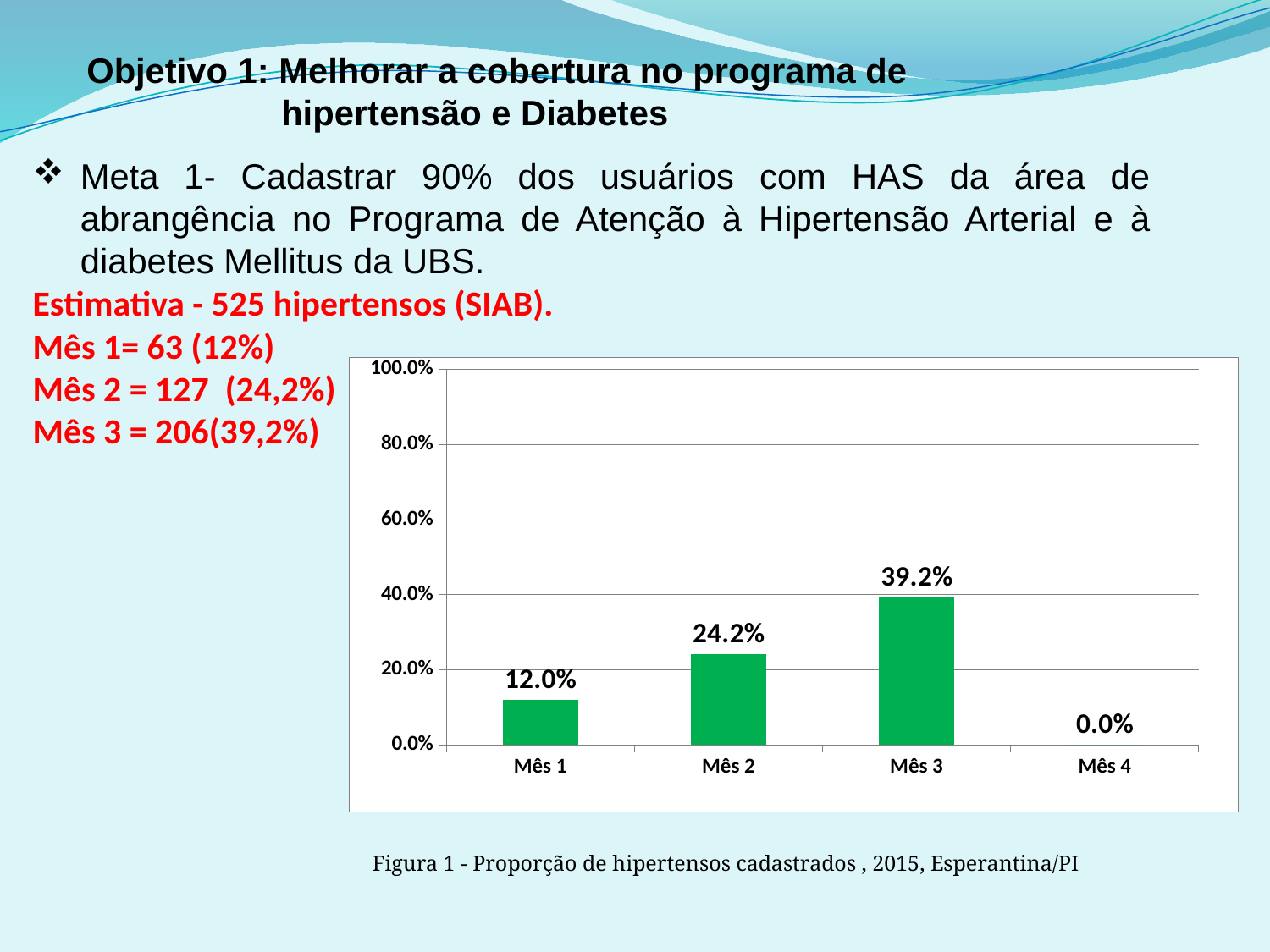
What is the value for Mês 1? 12.0% How many categories are shown on the x axis? 4 Which category has the lowest value? Mês 4 What is the difference between the values for Mês 3 and Mês 2? 15.0% What kind of chart is shown? bar chart What is the value for Mês 4? 0.0% Do the values rise or fall from Mês 1 to Mês 3? rise Which is larger, the value for Mês 2 or the value for Mês 1? Mês 2 Is the value for Mês 3 greater or less than 40.0%? less What is the value for Mês 2? 24.2% Which category has the highest value? Mês 3 What is the value for Mês 3? 39.2%